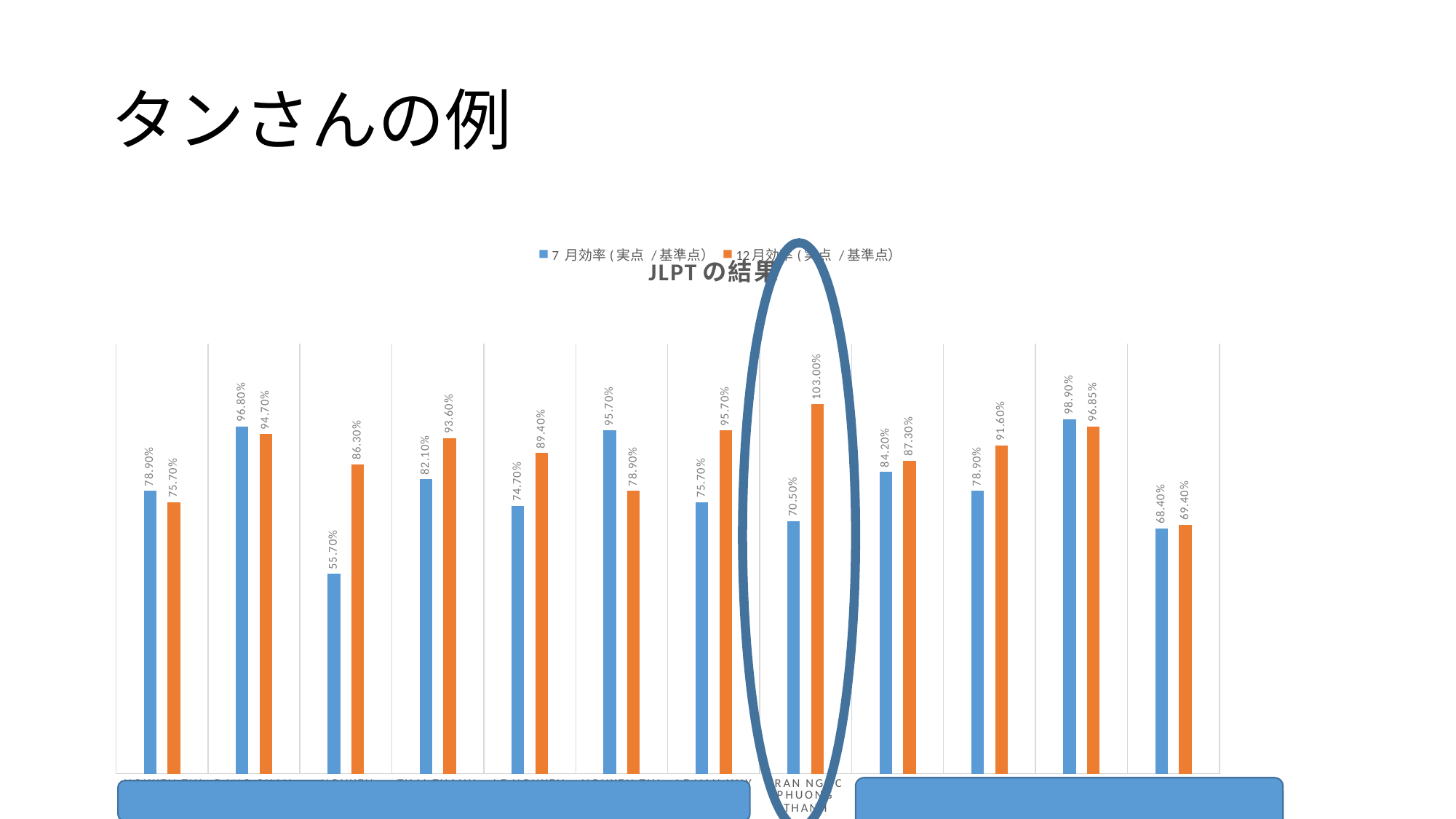
How many categories (pairs of bars) are plotted in the chart? 12 What kind of chart is shown on the slide? bar chart For the circled category, TRAN NGOC PHUONG THANH, which is larger: the 7月効率 value or the 12月効率 value? 12月効率 What is the title of the chart? JLPTの結果 What is the lowest 7月効率 (blue) value shown in the chart? 55.70% How many series does the chart's legend list? 2 What is the 12月効率 (orange) value for the circled category, TRAN NGOC PHUONG THANH? 103.00% Which colour represents the 7月効率 (実点/基準点) series in the chart? blue What is the highest 7月効率 (blue) value shown in the chart? 98.90% For the circled category, TRAN NGOC PHUONG THANH, by how many percentage points does the 12月効率 value exceed the 7月効率 value? 32.50 percentage points What is the highest 12月効率 (orange) value shown in the chart? 103.00% What is the 7月効率 (blue) value for the circled category, TRAN NGOC PHUONG THANH? 70.50%